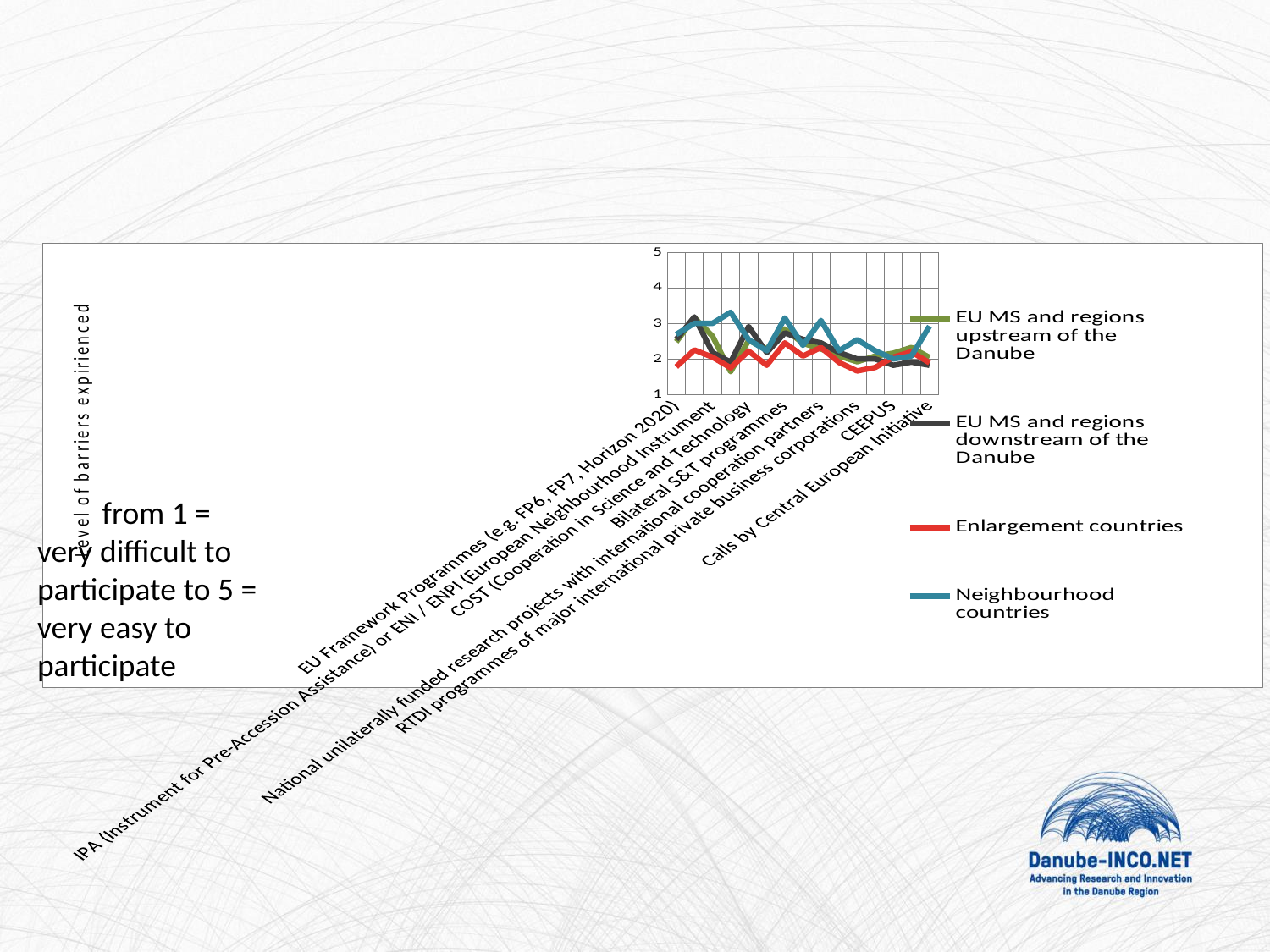
Is the value for EU MS and regions upstream of the Danube at the first category (IPA / ENI / ENPI) greater or less than 2? greater Is the value for Neighbourhood countries at the last category (Calls by Central European Initiative) greater or less than 2? greater What kind of chart is shown on the slide? line chart Does any series on the chart reach a value of 4 or higher? No Which series in the chart is drawn in red? Enlargement countries What is the highest value shown on the chart's vertical axis? 5 How many series does the chart's legend list? 4